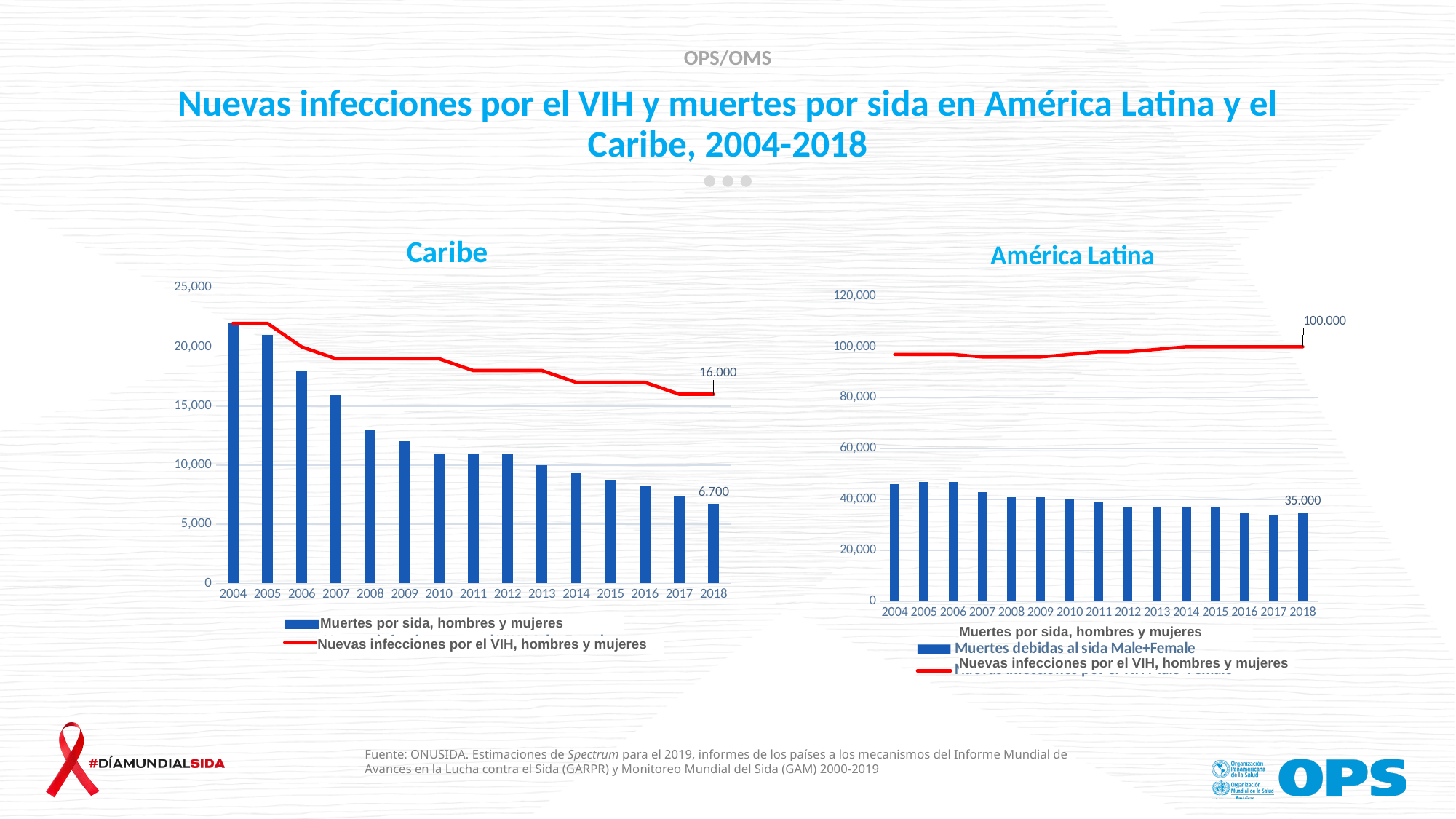
In the América Latina chart, is the bar for AIDS deaths in 2004 greater or less than 40,000? greater In the Caribe chart, what is the data label shown for AIDS deaths (Muertes por sida) in 2018? 6.700 In the Caribe chart, do AIDS deaths rise or fall from 2004 to 2018? fall In the América Latina chart, what is the data label shown for new HIV infections in 2018? 100.000 In the Caribe chart, which year has the highest bar for AIDS deaths? 2004 How many years are shown on the x axis of the Caribe chart? 15 What kind of chart is the Caribe chart? Combined bar and line chart How many series does the legend of the Caribe chart list? 2 In the Caribe chart, what is the data label shown for new HIV infections (Nuevas infecciones por el VIH) in 2018? 16.000 In the Caribe chart, is the bar for AIDS deaths in 2004 greater or less than 20,000? greater In the América Latina chart, what is the data label shown for AIDS deaths in 2018? 35.000 In the Caribe chart, which year has the lowest bar for AIDS deaths? 2018